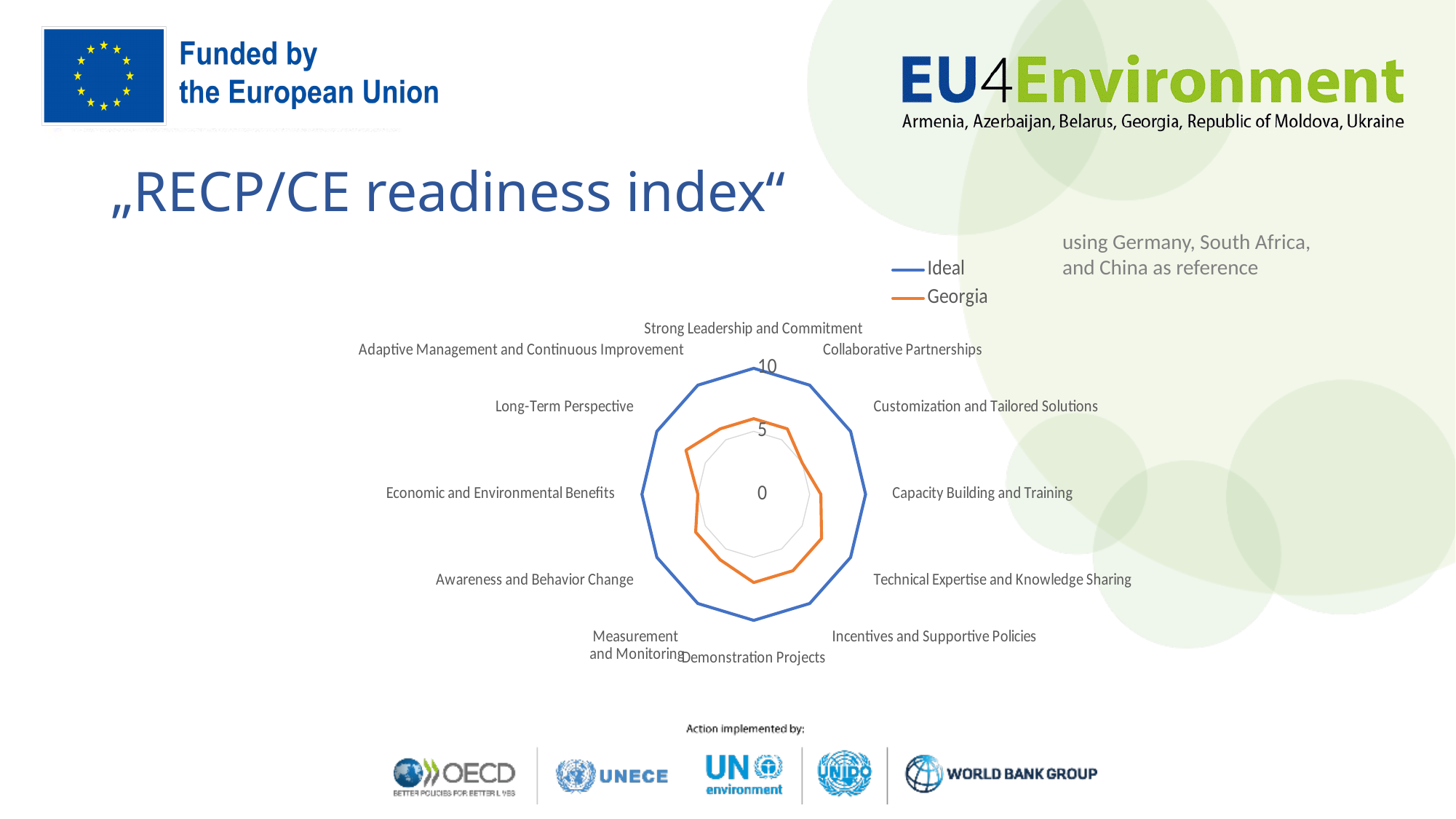
Is the Georgia value for Incentives and Supportive Policies greater or less than 5? greater Is the Georgia value for Strong Leadership and Commitment greater or less than 10? less What kind of chart is shown on the slide? Radar chart What is the value of the Ideal series for Demonstration Projects? 10 Which series is drawn in orange in the chart? Georgia Is the Georgia value for Demonstration Projects greater or less than 5? greater What is the value of the Ideal series for Strong Leadership and Commitment? 10 Which countries does the slide say are used as reference for the index? Germany, South Africa, and China How many categories (axes) does the radar chart have? 12 How many series does the chart legend list? 2 Which series has the larger value for Capacity Building and Training, Ideal or Georgia? Ideal